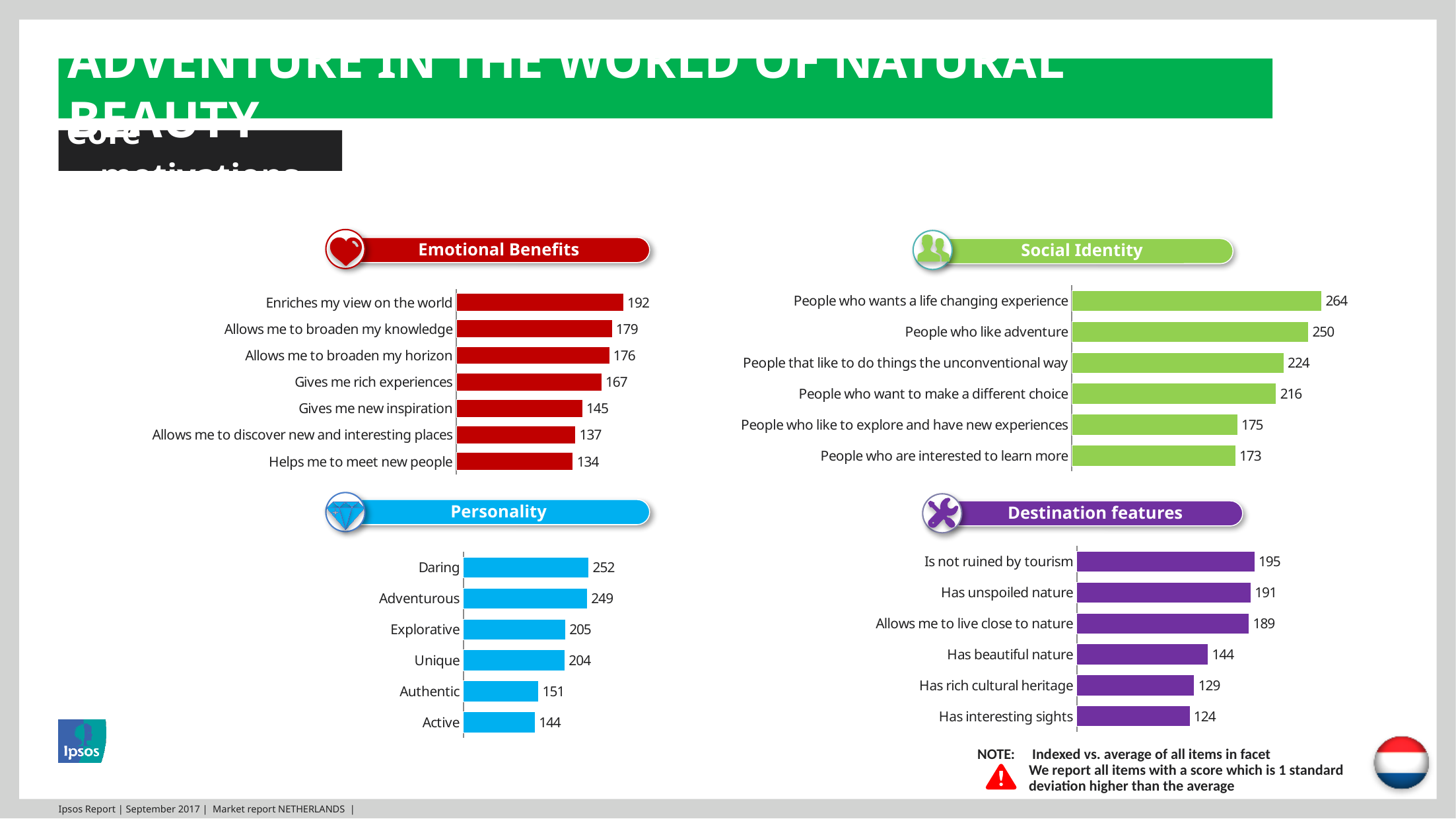
In the Social Identity chart, which category has the lowest value? People who are interested to learn more In the Personality chart, what is the value for "Explorative"? 205 How many categories are shown in the Social Identity chart? 6 In the Emotional Benefits chart, what is the value for "Gives me new inspiration"? 145 In the Social Identity chart, what is the value for "People who like adventure"? 250 In the Destination features chart, what is the value for "Has rich cultural heritage"? 129 In the Emotional Benefits chart, which category has the highest value? Enriches my view on the world In the Destination features chart, what is the difference between "Has unspoiled nature" and "Has interesting sights"? 67 What kind of chart is the Personality chart? Bar chart In the Personality chart, which is larger, "Daring" or "Active"? Daring In the Destination features chart, which category has the highest value? Is not ruined by tourism In the Emotional Benefits chart, what is the difference between "Enriches my view on the world" and "Helps me to meet new people"? 58